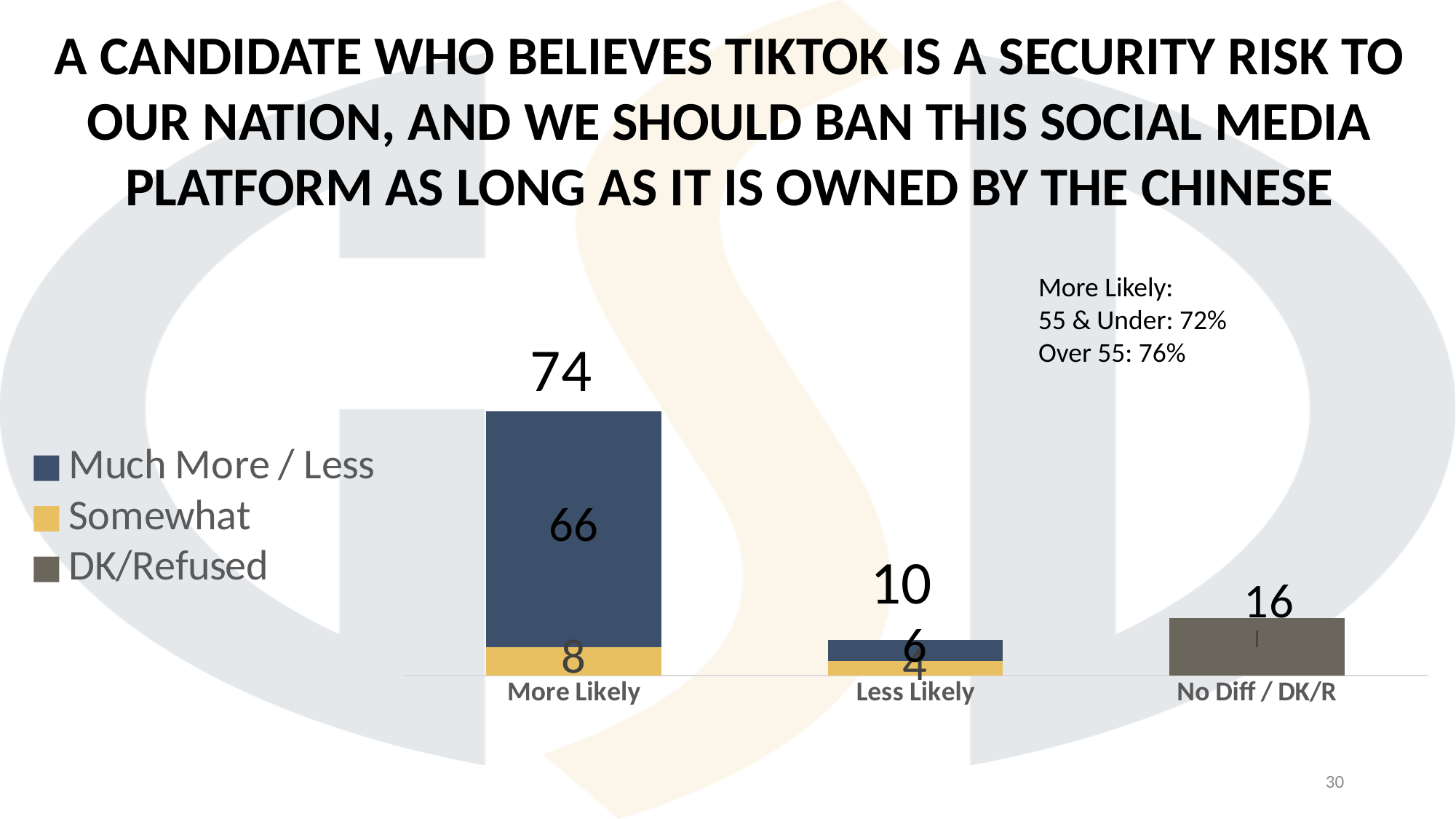
What is the Much More / Less value for More Likely? 66 Which category has the lowest total? Less Likely What is the total value shown above the Less Likely bar? 10 How many series does the legend list? 3 What is the total value shown above the More Likely bar? 74 What kind of chart is shown on the slide? Stacked bar chart What is the Somewhat value for Less Likely? 4 What is the value for No Diff / DK/R? 16 Which category has the highest total? More Likely What is the difference between the More Likely total and the Less Likely total? 64 What is the Somewhat value for More Likely? 8 What is the Much More / Less value for Less Likely? 6